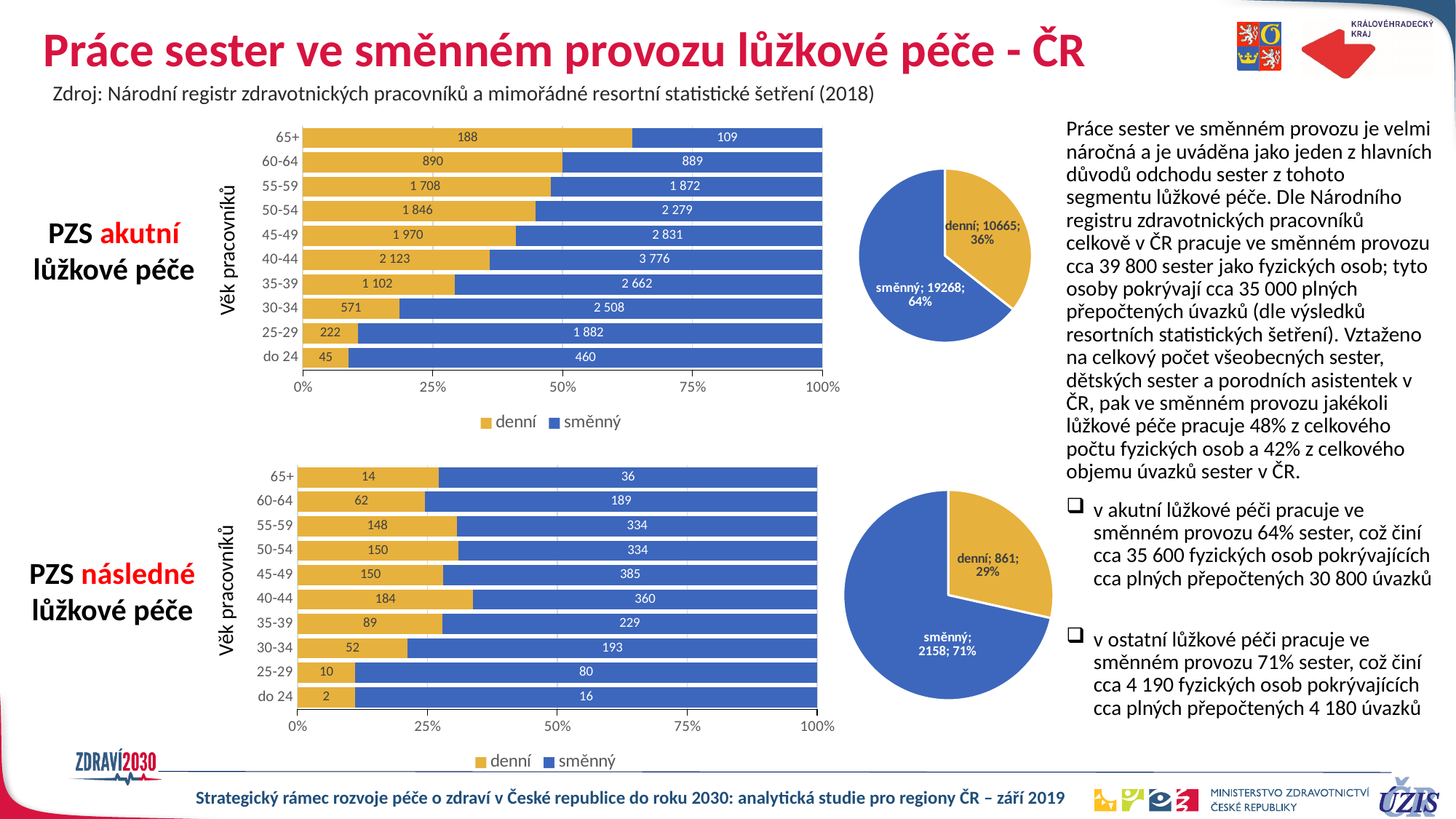
In the PZS akutní lůžkové péče bar chart, is the denní share of the 65+ bar greater or less than 50%? greater In the lower pie chart (PZS následné lůžkové péče), what is the value for denní? 861 In the PZS následné lůžkové péče bar chart, which age group has the larger směnný value: 35-39 or 30-34? 35-39 In the upper pie chart (PZS akutní lůžkové péče), what share does směnný have? 64% In the PZS následné lůžkové péče bar chart, which age group has the lowest směnný value? do 24 How many series does the legend of the PZS následné lůžkové péče bar chart list? 2 In the PZS akutní lůžkové péče bar chart, what is the směnný value for the 40-44 age group? 3 776 How many age groups are shown in the PZS akutní lůžkové péče bar chart? 10 In the PZS akutní lůžkové péče bar chart, which age group has the highest denní value? 40-44 What type of chart is used for the PZS akutní lůžkové péče age breakdown on the left? Bar chart In the PZS následné lůžkové péče bar chart, what is the denní value for the 45-49 age group? 150 In the PZS akutní lůžkové péče bar chart, what is the difference between the směnný and denní values for the 55-59 age group? 164